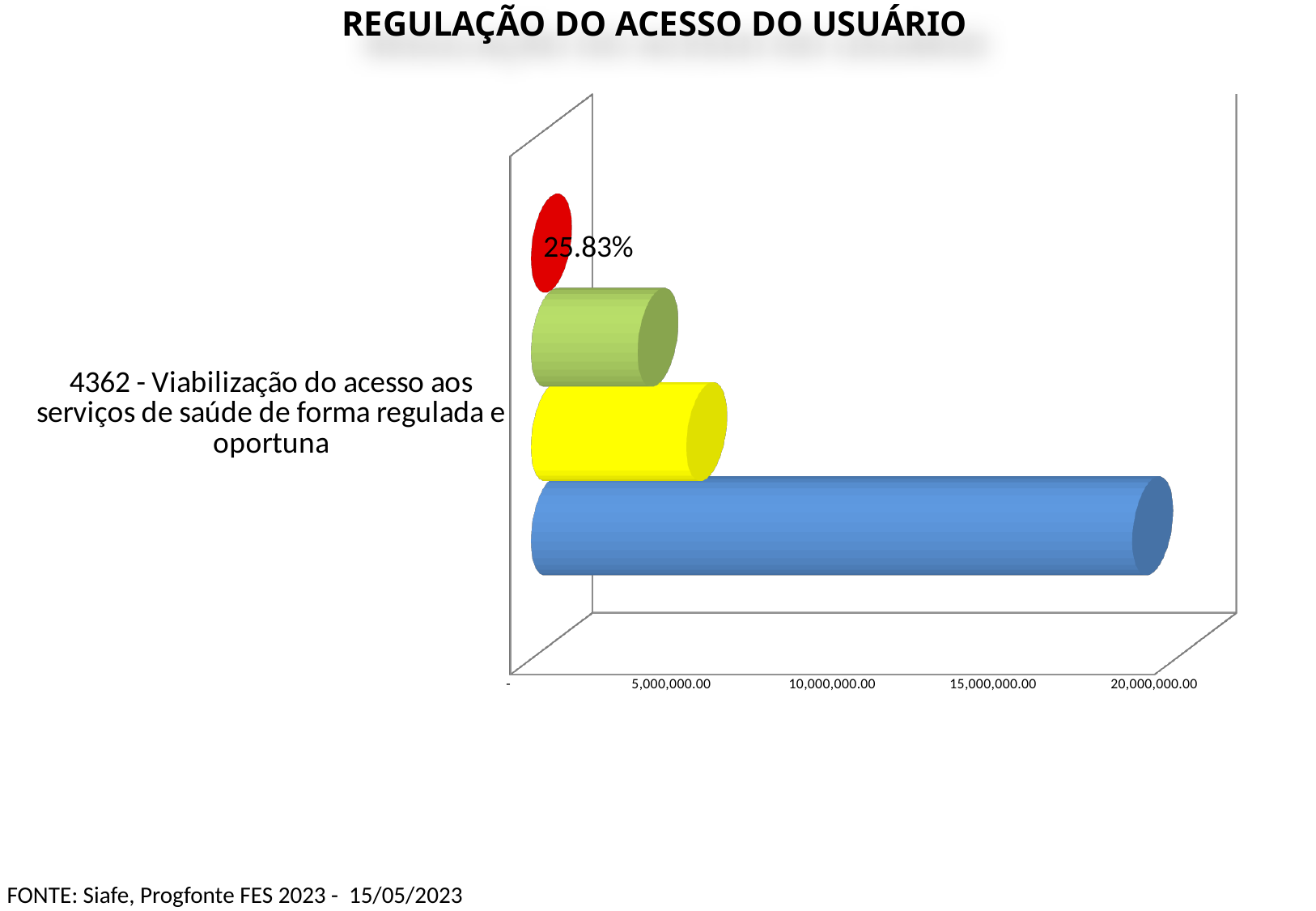
Is the value of the green bar greater or less than 10,000,000.00? less Is the value of the yellow bar greater or less than 10,000,000.00? less How many categories are shown on the vertical axis of the chart? 1 How many bars are plotted for the category "4362 - Viabilização do acesso aos serviços de saúde de forma regulada e oportuna"? 4 Is the value of the blue bar greater or less than 15,000,000.00? greater What kind of chart is shown on the slide? bar chart What is the highest value labelled on the horizontal axis? 20,000,000.00 What percentage is printed as a data label on the red bar? 25.83% Which coloured bar is the shortest in the chart? red Which bar is longer, the yellow bar or the green bar? yellow What is the title of the chart? REGULAÇÃO DO ACESSO DO USUÁRIO Which coloured bar is the longest in the chart? blue